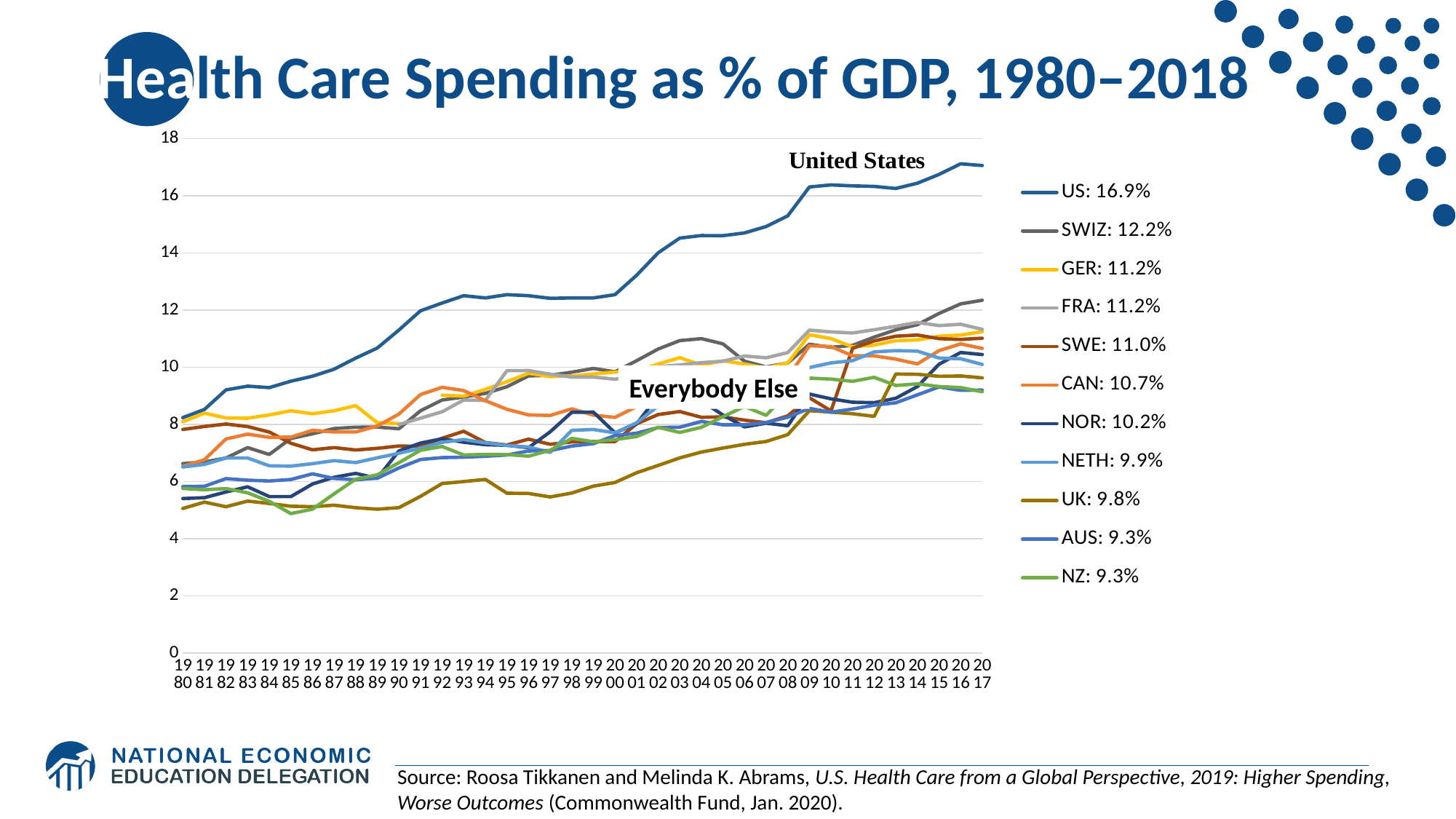
What value does the legend give for SWIZ? 12.2% Which country has the highest health care spending as % of GDP according to the legend? US Does the United States line rise or fall from 1980 to 2017? rises What is the title of the chart on the slide? Health Care Spending as % of GDP, 1980–2018 What value does the legend give for the US? 16.9% Is the value for the United States in 1980 greater or less than 10? less What is the difference between the legend values for the US (16.9%) and SWIZ (12.2%)? 4.7% Which is larger, the legend value for the US or for SWIZ? US What kind of chart is shown on the slide? line chart How many series does the legend list? 11 What value does the legend give for CAN? 10.7% Is the value for the United States in 2017 greater or less than 16? greater